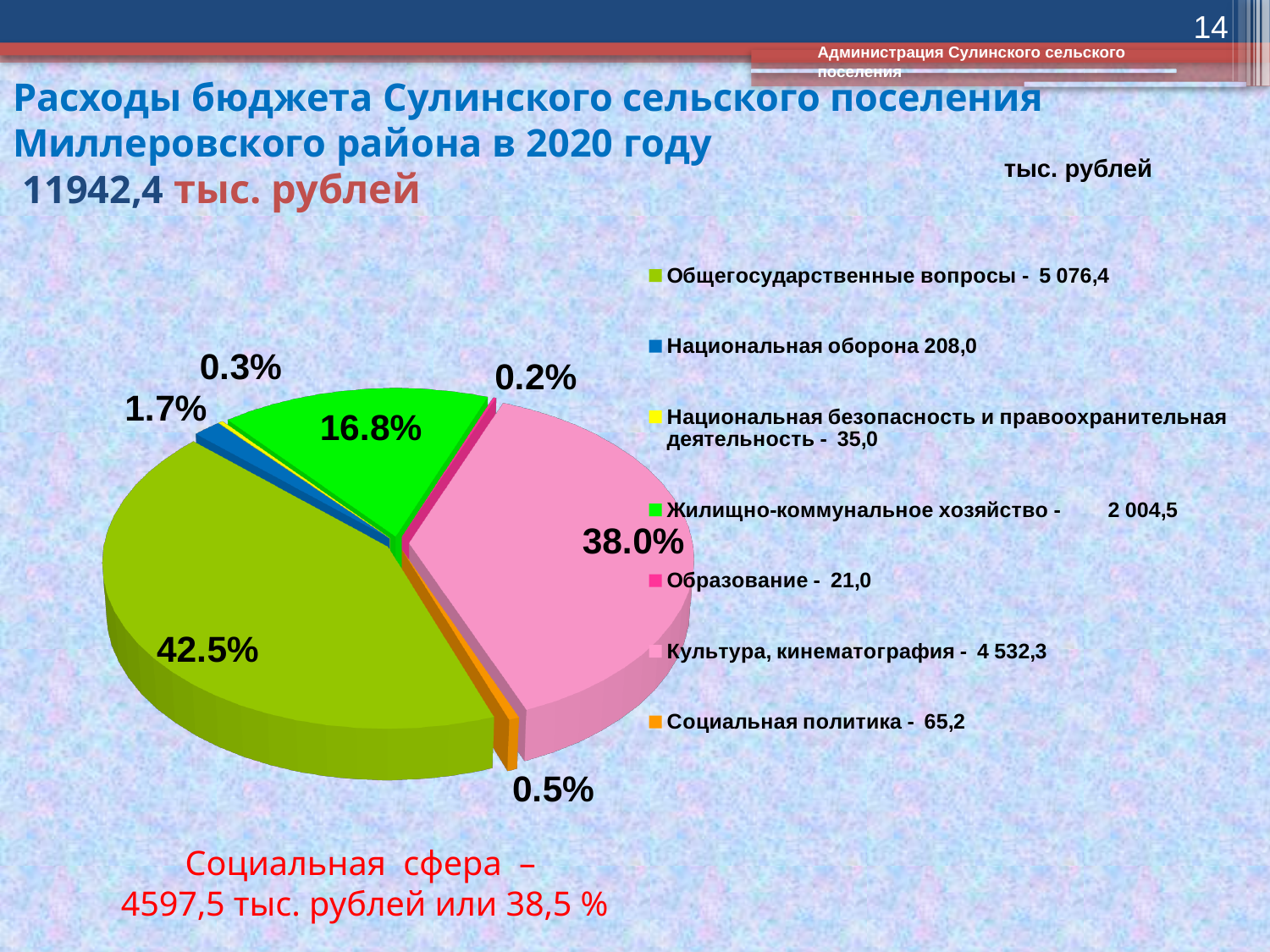
What share of the pie does Культура, кинематография take? 38.0% What is the difference in percentage points between the Общегосударственные вопросы slice and the Культура, кинематография slice? 4.5% Which category has the largest slice of the pie? Общегосударственные вопросы What kind of chart is shown on the slide? pie chart Which is larger, the slice for Национальная оборона or the slice for Социальная политика? Национальная оборона How many categories does the pie chart have? 7 What colour is the slice for Культура, кинематография? pink What value is listed in the legend for Социальная политика? 65,2 What share of the pie does Общегосударственные вопросы take? 42.5% Which category has the smallest slice of the pie? Образование What value is listed in the legend for Жилищно-коммунальное хозяйство? 2 004,5 What share of the pie does Жилищно-коммунальное хозяйство take? 16.8%